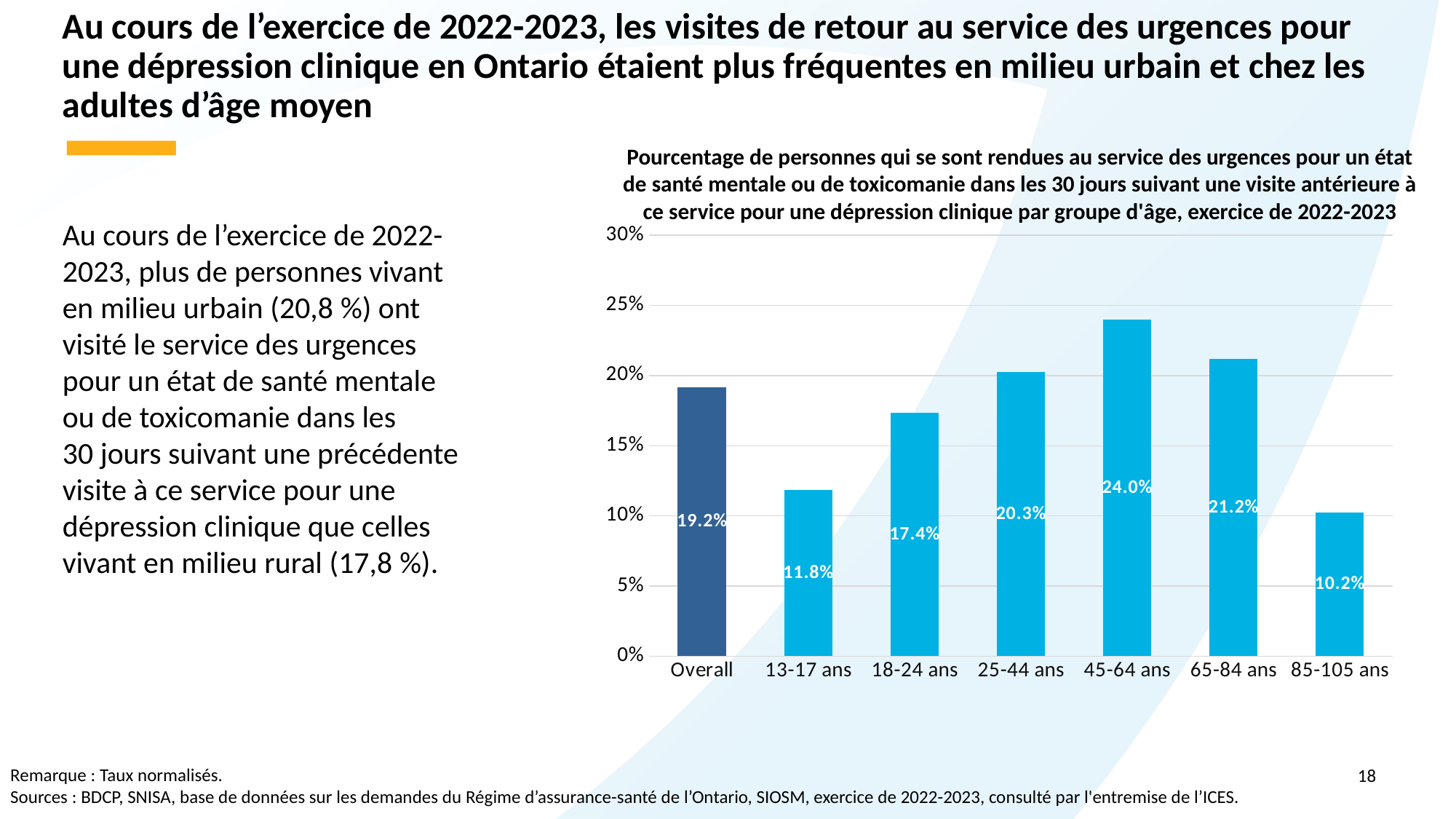
What is the value for the 85-105 ans age group? 10.2% Which category has the lowest value? 85-105 ans How many bars are shown in the chart? 7 What is the difference between the values for 45-64 ans and 13-17 ans? 12.2% What kind of chart is shown on the slide? Bar chart Which bar is shown in a different (dark blue) colour from the others? Overall Is the value for 65-84 ans greater or less than 20%? greater What is the value for the Overall bar? 19.2% What is the difference between the Overall value and the value for 85-105 ans? 9.0% What is the value for the 45-64 ans age group? 24.0% Which age group has the highest value? 45-64 ans Which is larger, the value for 18-24 ans or the value for 25-44 ans? 25-44 ans